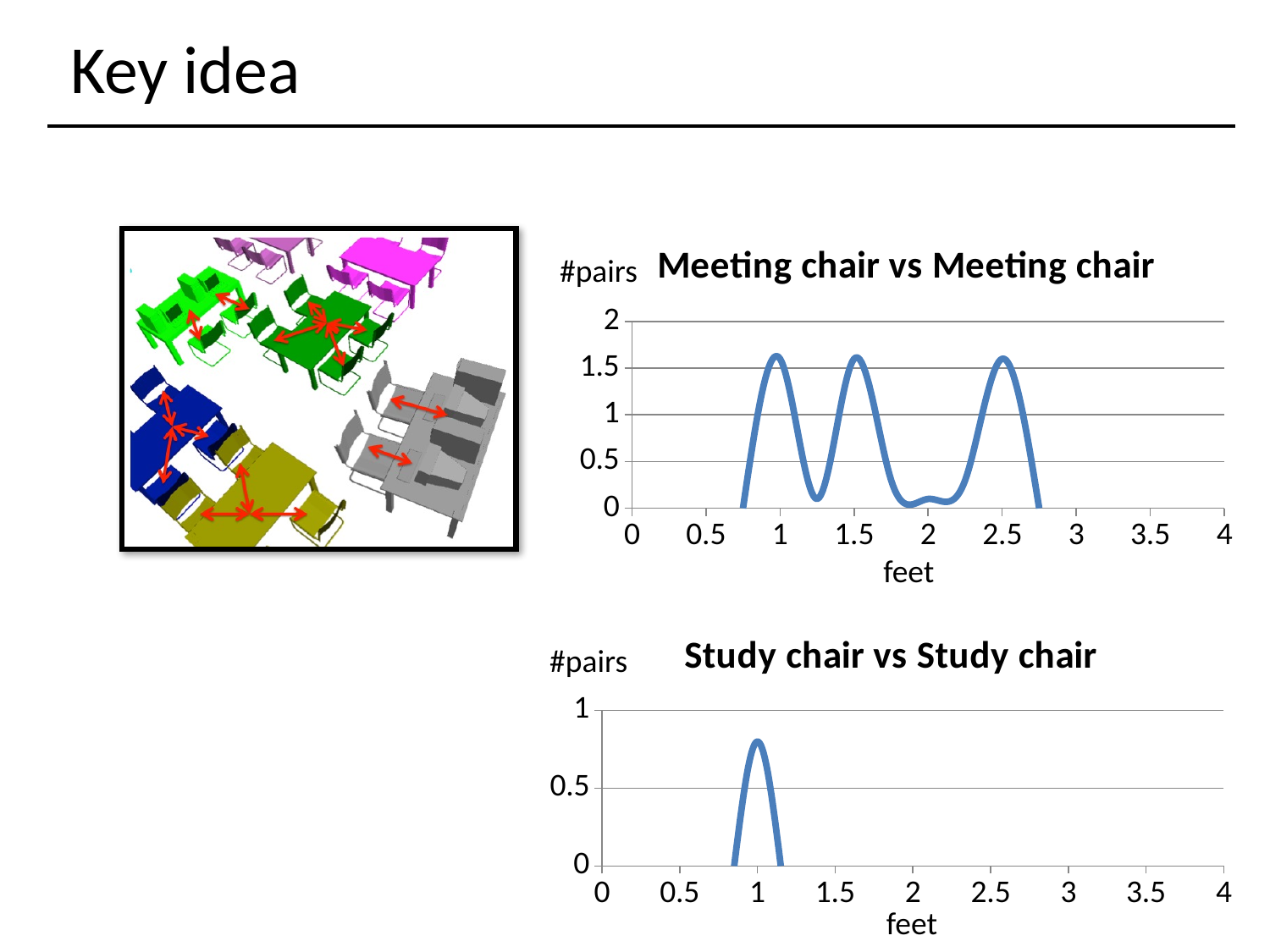
What is the x-axis label on the "Study chair vs Study chair" chart? feet In the "Study chair vs Study chair" chart, is the value at 1 foot greater or less than 0.5? greater What is the y-axis label on the "Meeting chair vs Meeting chair" chart? #pairs In the "Meeting chair vs Meeting chair" chart, is the value at 2 feet greater or less than 0.5? less In the "Meeting chair vs Meeting chair" chart, is the value at 2.5 feet greater or less than 1? greater What kind of chart is the "Study chair vs Study chair" chart? line chart What kind of chart is the "Meeting chair vs Meeting chair" chart? line chart In the "Meeting chair vs Meeting chair" chart, is the value at 1 foot larger or smaller than the value at 2 feet? larger